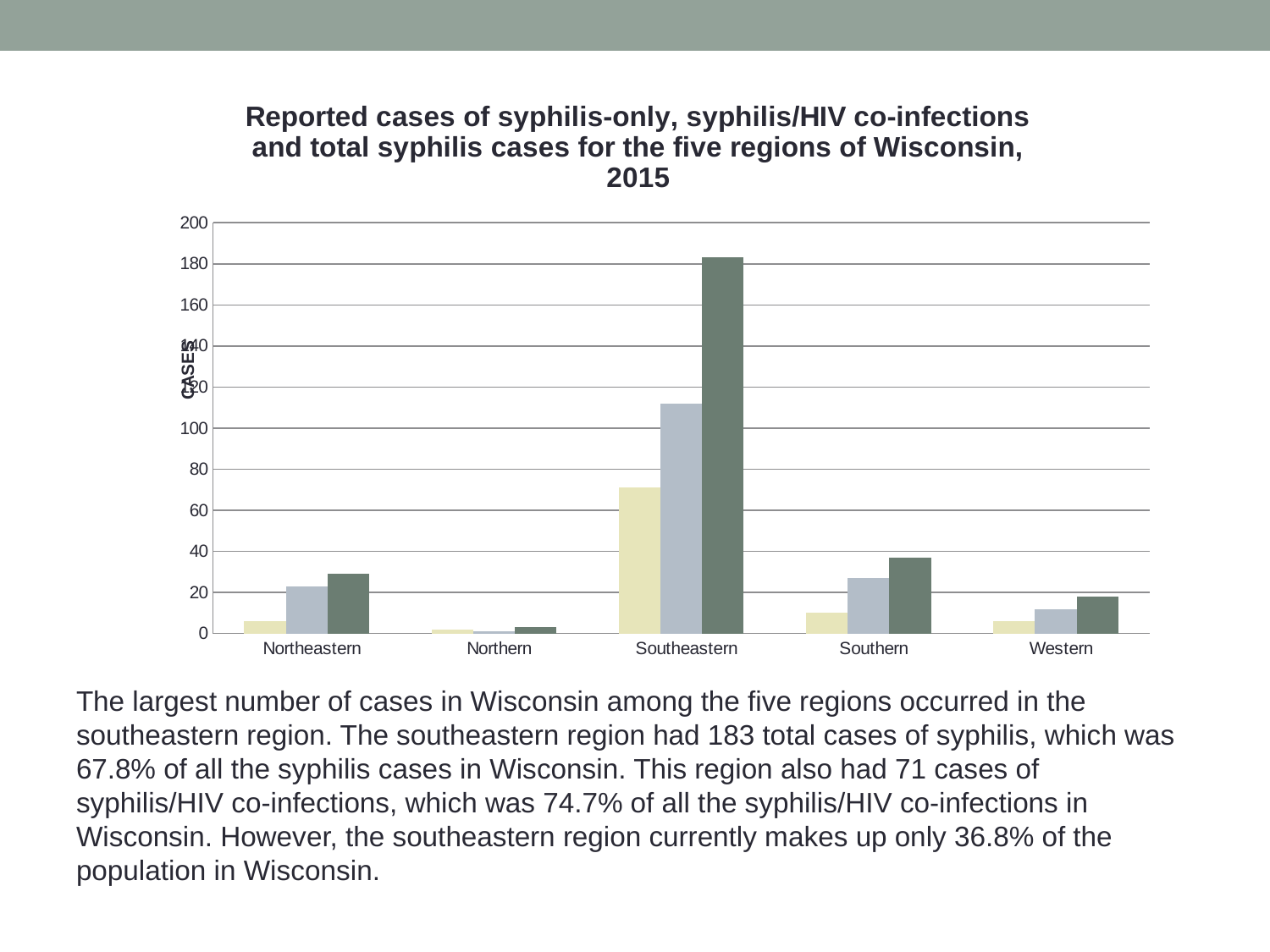
Which region has the lowest bars in the chart? Northern How many bars are plotted for each region in the chart? 3 What kind of chart is shown on the slide? bar chart How many regions are shown along the x axis of the chart? 5 Is the tallest bar for Western greater or less than 40? less Is the tallest bar for Southern greater or less than 40? less Which region has the taller tallest bar, Northeastern or Southern? Southern Which region has the tallest bar in the chart? Southeastern What is the label on the y axis of the chart? CASES Is the tallest bar for Northeastern greater or less than 20? greater